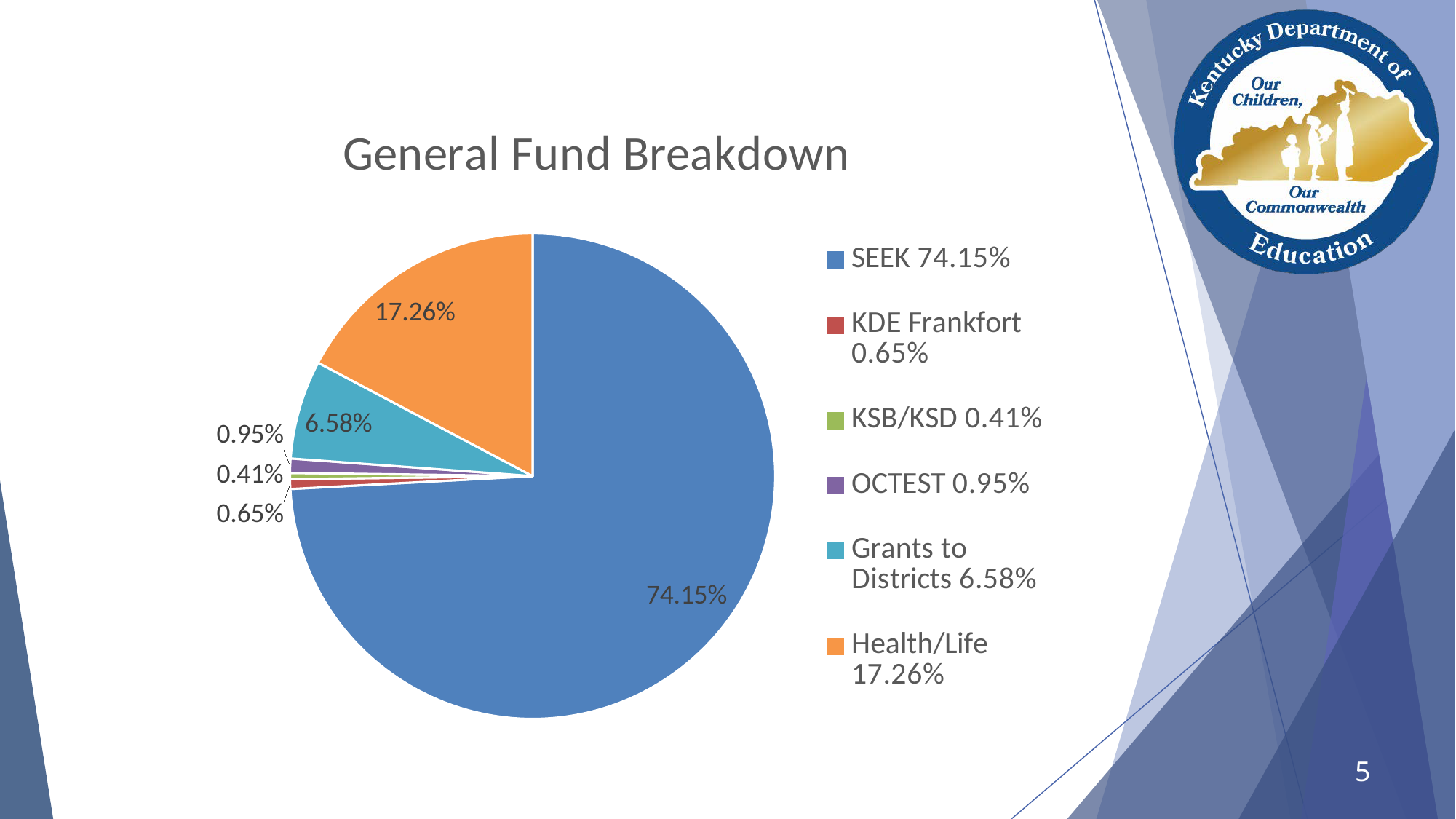
Which is larger, the share for Health/Life or the share for Grants to Districts? Health/Life Which category has the largest share of the General Fund? SEEK What share of the General Fund does KDE Frankfort represent? 0.65% What type of chart is shown on the slide? pie chart Which category has the smallest share of the General Fund? KSB/KSD What share of the General Fund does Grants to Districts represent? 6.58% What share of the General Fund does SEEK represent? 74.15% What share of the General Fund does Health/Life represent? 17.26% What is the title of the chart? General Fund Breakdown How many categories does the pie chart show? 6 What share of the General Fund does OCTEST represent? 0.95% What is the difference between the SEEK share and the Health/Life share? 56.89%